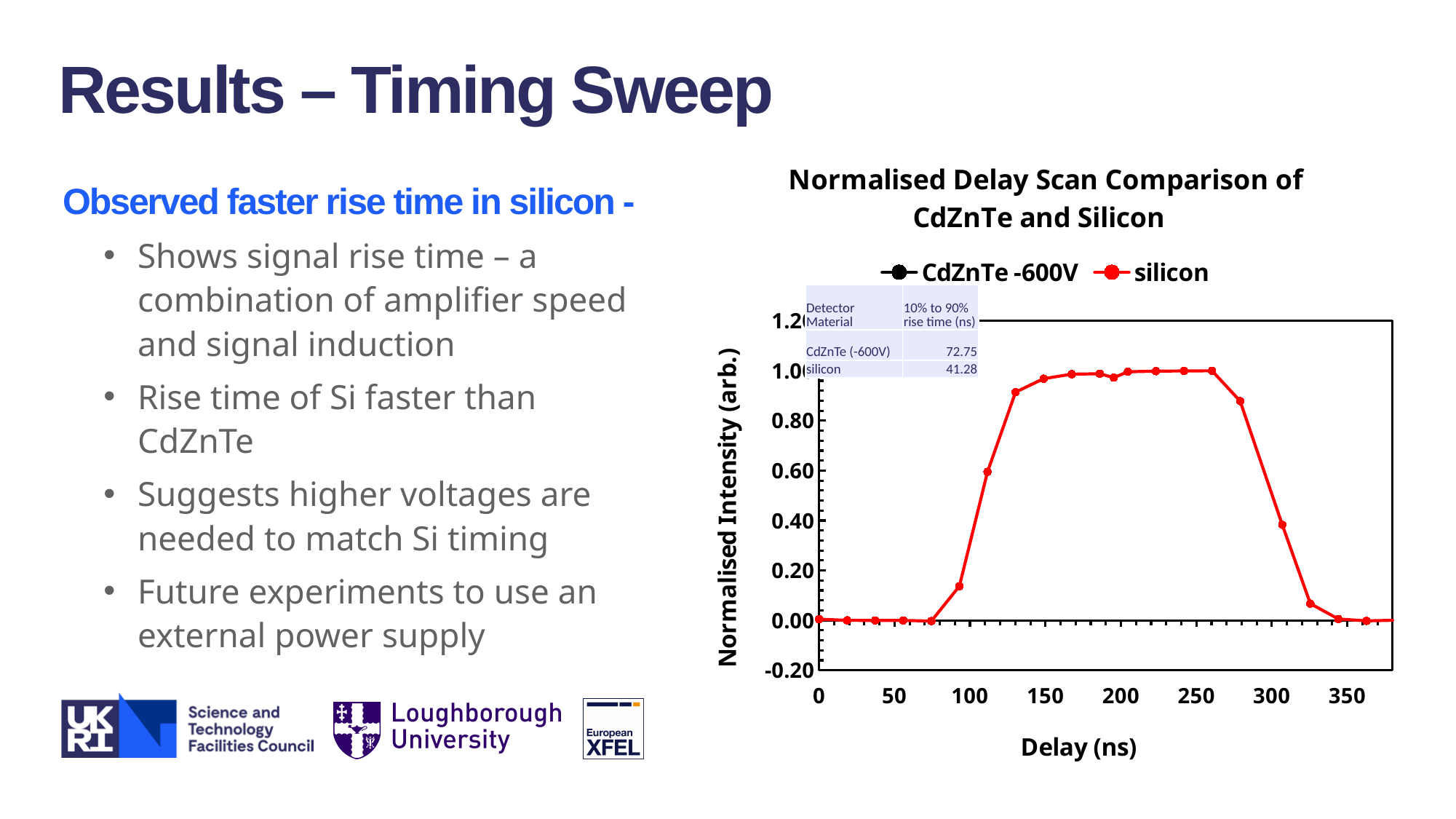
Does the silicon normalised intensity rise or fall as the delay increases from 250 ns to 350 ns? fall How many series does the legend of the chart list? 2 According to the table inset in the chart, what is the 10% to 90% rise time (ns) for silicon? 41.28 What is the difference between the 10% to 90% rise times of CdZnTe (-600V) and silicon in the inset table? 31.47 What kind of chart is shown on the slide? line chart Which detector material has the longer 10% to 90% rise time in the inset table, CdZnTe (-600V) or silicon? CdZnTe (-600V) What is the title of the chart? Normalised Delay Scan Comparison of CdZnTe and Silicon What is the label of the x axis of the chart? Delay (ns) According to the table inset in the chart, what is the 10% to 90% rise time (ns) for CdZnTe (-600V)? 72.75 Is the silicon normalised intensity at a delay of 50 ns greater or less than 0.20? less Is the silicon normalised intensity at a delay of 200 ns greater or less than 0.80? greater